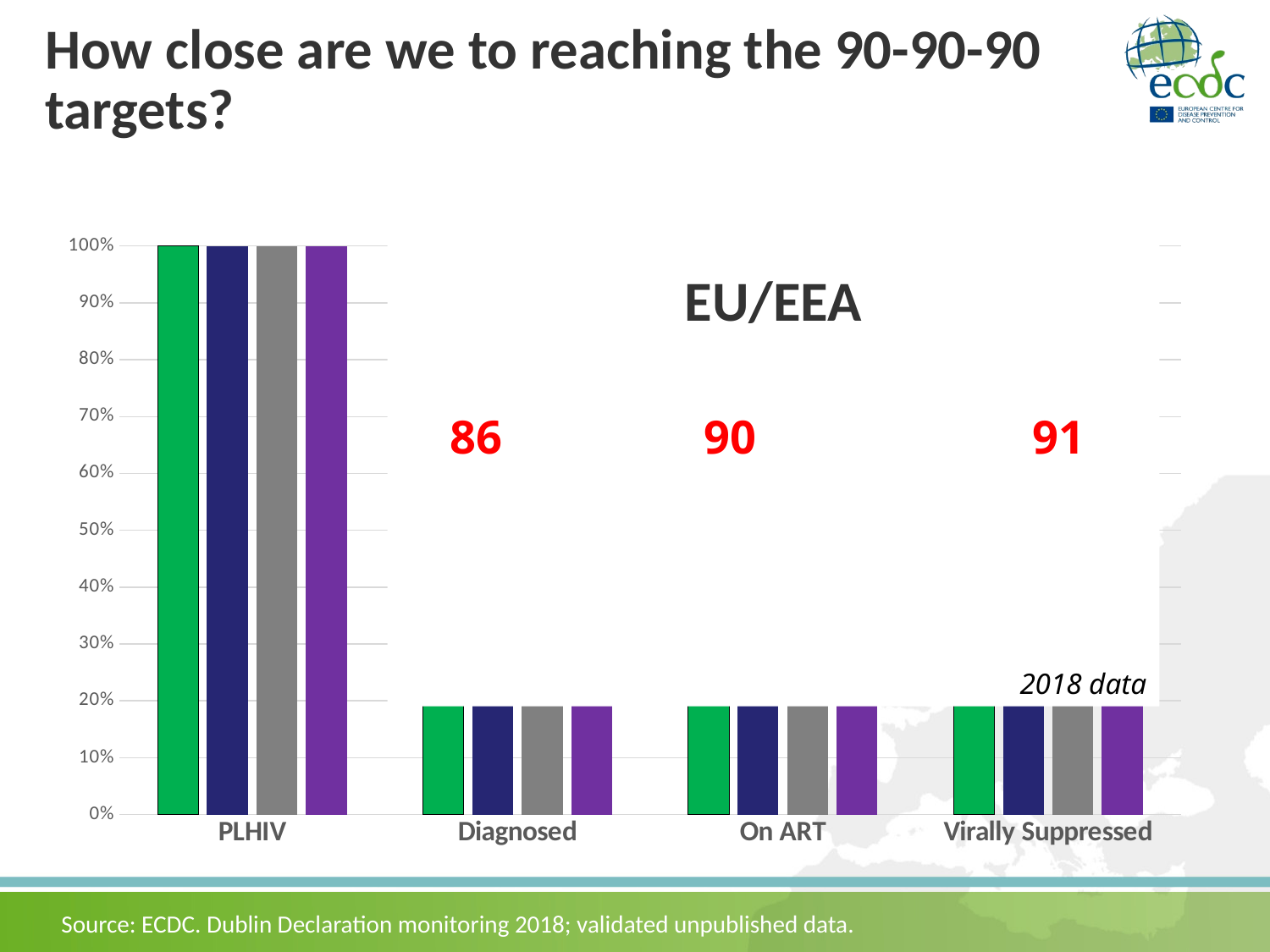
What kind of chart is shown on the slide? bar chart What value do the bars for PLHIV reach on the chart? 100% Which category has the highest bars on the chart? PLHIV Is the value for On ART greater or less than 10%? greater Which is larger on the chart, the value for PLHIV or the value for Diagnosed? PLHIV How many bars are plotted for each category on the chart? 4 Is the value for Virally Suppressed greater or less than 50%? less What region label is printed in large text inside the chart area? EU/EEA How many categories are shown on the x axis of the chart? 4 What is the highest value shown on the y axis of the chart? 100% Is the value for Diagnosed greater or less than 30%? less